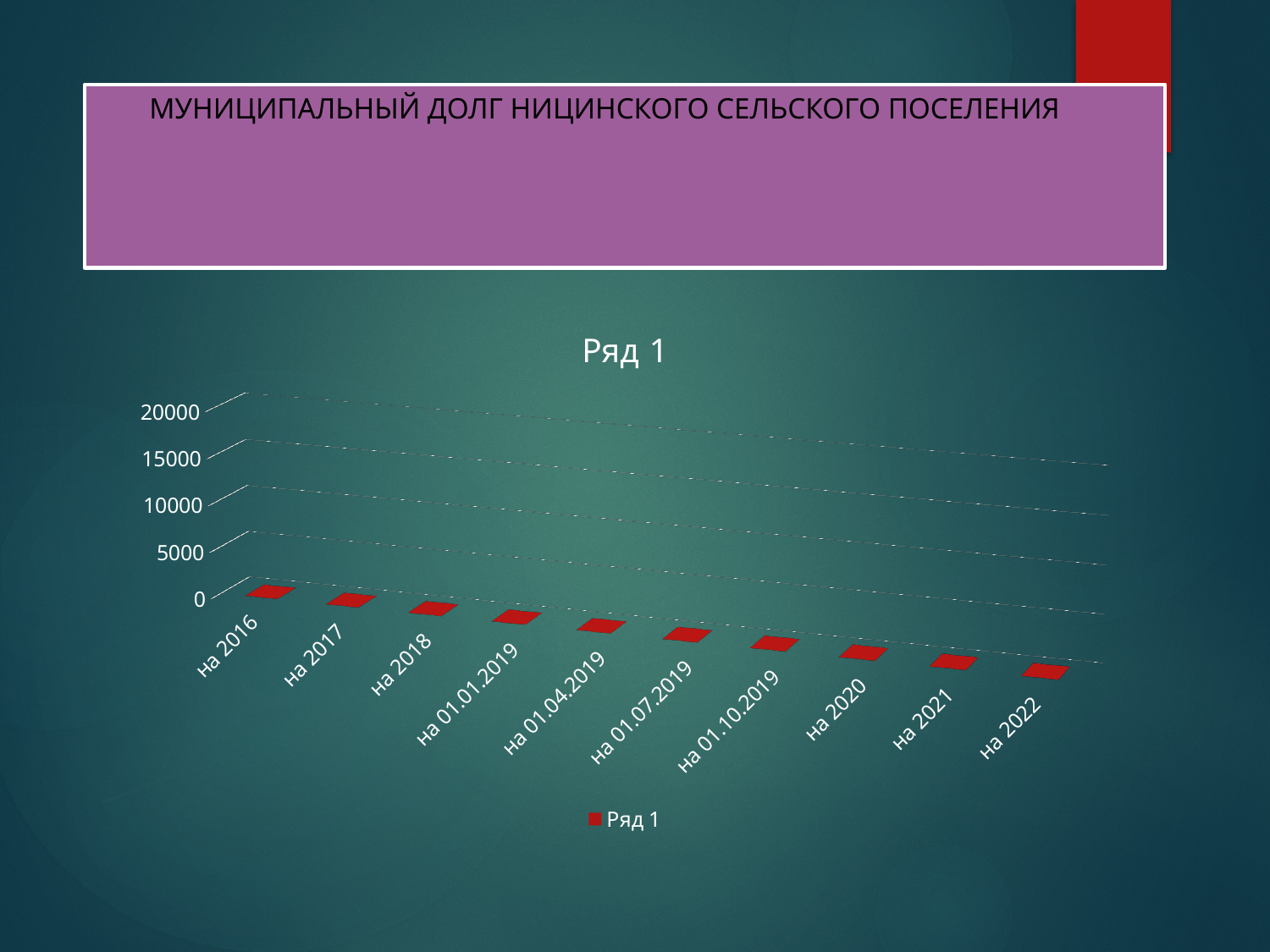
Which category label comes first on the x axis of the chart? на 2016 Is the value for "на 01.04.2019" greater or less than 5000? less Is the value for "на 2020" greater or less than 15000? less What kind of chart is shown on the slide? bar chart How many categories are shown along the x axis of the chart? 10 What is the name of the series shown in the chart legend? Ряд 1 Which category label comes last on the x axis of the chart? на 2022 Is the value for "на 2016" greater or less than 5000? less How many series does the chart legend list? 1